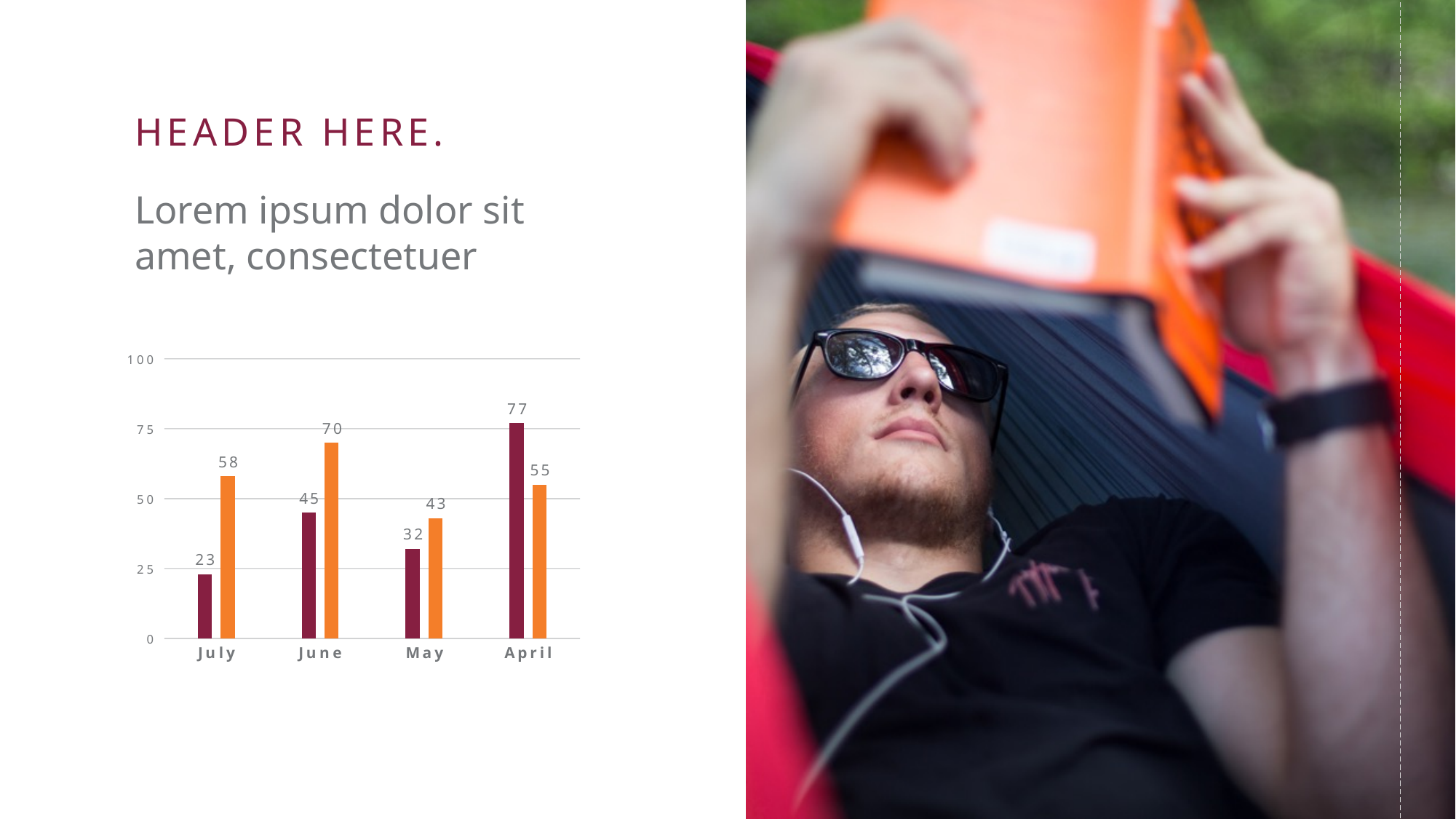
How many categories are shown on the x axis of the chart? 4 Is the value of the dark red bar for June greater or less than 50? less Which category has the lowest orange bar? May What is the highest value shown on the y axis of the chart? 100 Which category has the highest dark red bar? April Which is larger for April, the dark red bar or the orange bar? the dark red bar What is the value of the orange bar for May? 43 What is the value of the dark red bar for April? 77 What type of chart is shown on the slide? bar chart What is the value of the orange bar for June? 70 What is the value of the dark red bar for July? 23 What is the difference between the orange bar and the dark red bar for July? 35